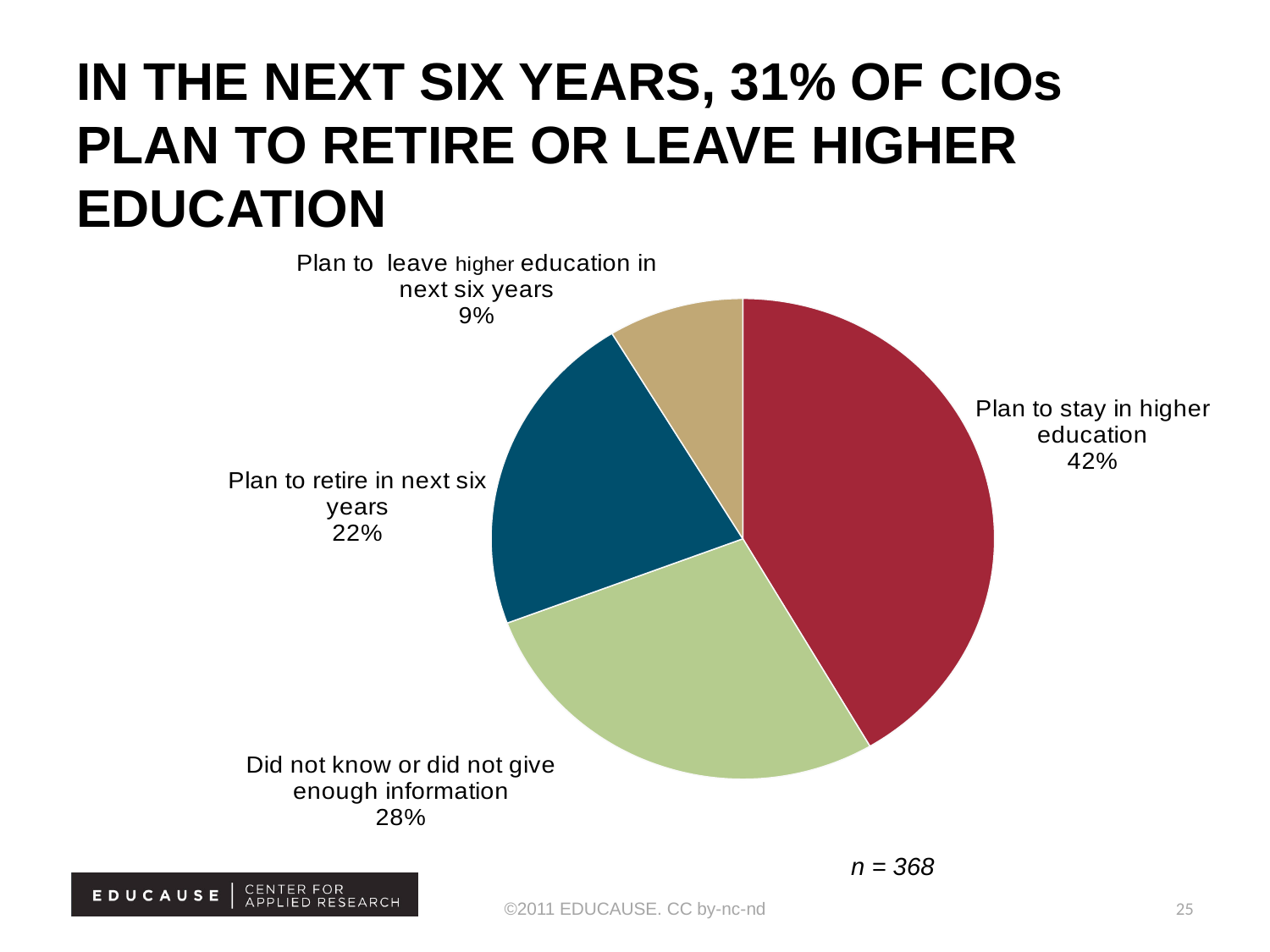
What kind of chart is shown on the slide? pie chart What is the sample size (n) shown on the slide? 368 What percentage of CIOs plan to stay in higher education? 42% How many slices does the pie chart have? 4 What percentage of CIOs plan to retire in the next six years? 22% What percentage of CIOs did not know or did not give enough information? 28% What is the difference in percentage points between those who plan to stay in higher education and those who plan to retire in the next six years? 20 What is the combined percentage of CIOs who plan to retire or leave higher education in the next six years? 31% What percentage of CIOs plan to leave higher education in the next six years? 9% Which is larger: the share that plans to retire in the next six years or the share that did not know or did not give enough information? Did not know or did not give enough information Which slice of the pie is the largest? Plan to stay in higher education Which slice of the pie is the smallest? Plan to leave higher education in next six years